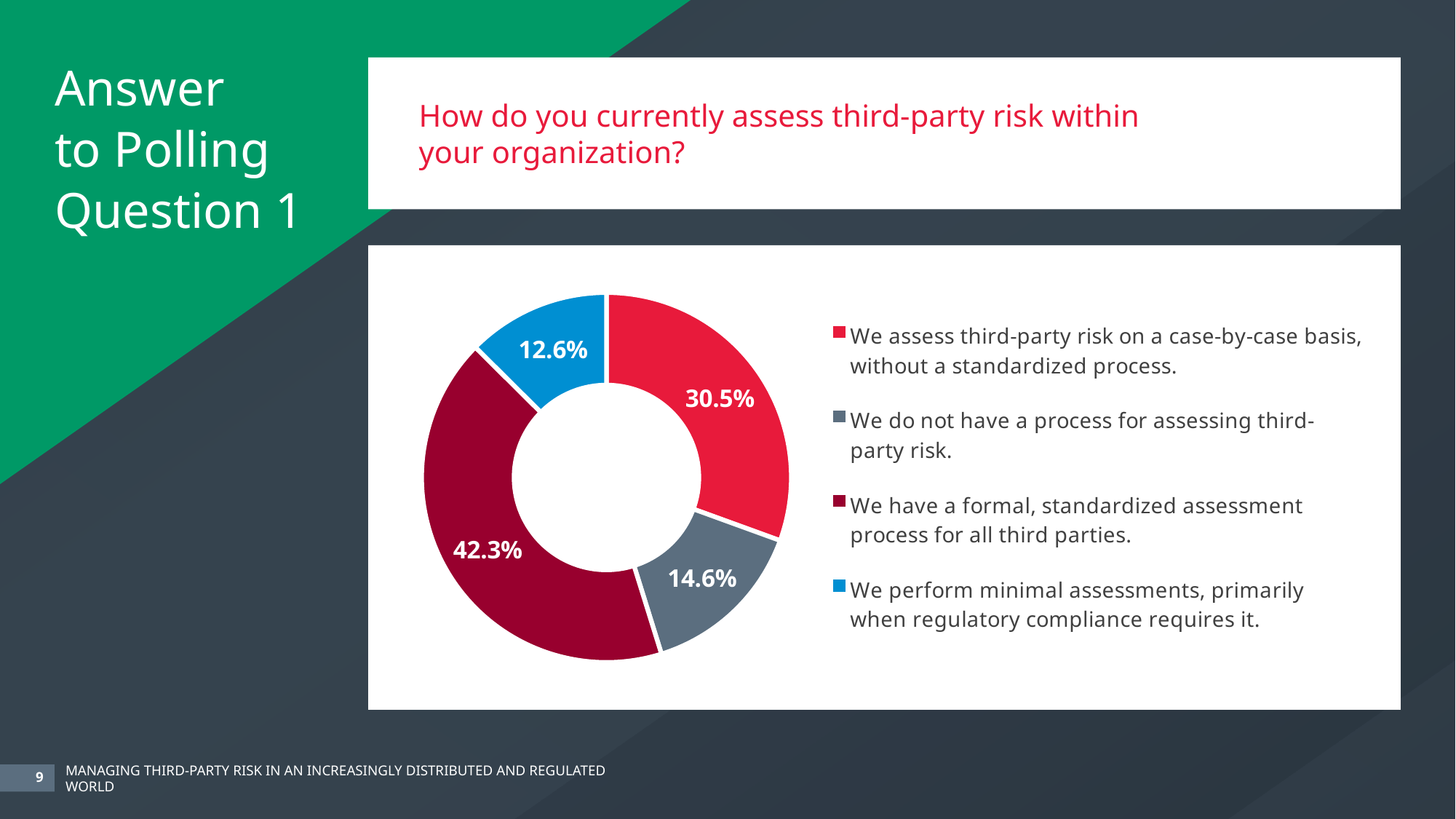
What colour represents the 'We perform minimal assessments, primarily when regulatory compliance requires it' response? Blue What is the difference in percentage points between the formal, standardized process response and the case-by-case basis response? 11.8 Which response received the largest share of the poll? We have a formal, standardized assessment process for all third parties. What percentage of respondents said they do not have a process for assessing third-party risk? 14.6% Which is larger: the share for 'We do not have a process for assessing third-party risk' or the share for 'We perform minimal assessments, primarily when regulatory compliance requires it'? We do not have a process for assessing third-party risk. What type of chart is used to show the polling results? Doughnut (pie) chart Which response received the smallest share of the poll? We perform minimal assessments, primarily when regulatory compliance requires it. What polling question does the chart present results for? How do you currently assess third-party risk within your organization? How many response options are shown in the chart? 4 What percentage of respondents said they perform minimal assessments, primarily when regulatory compliance requires it? 12.6% What percentage of respondents said they have a formal, standardized assessment process for all third parties? 42.3% What percentage of respondents said they assess third-party risk on a case-by-case basis, without a standardized process? 30.5%